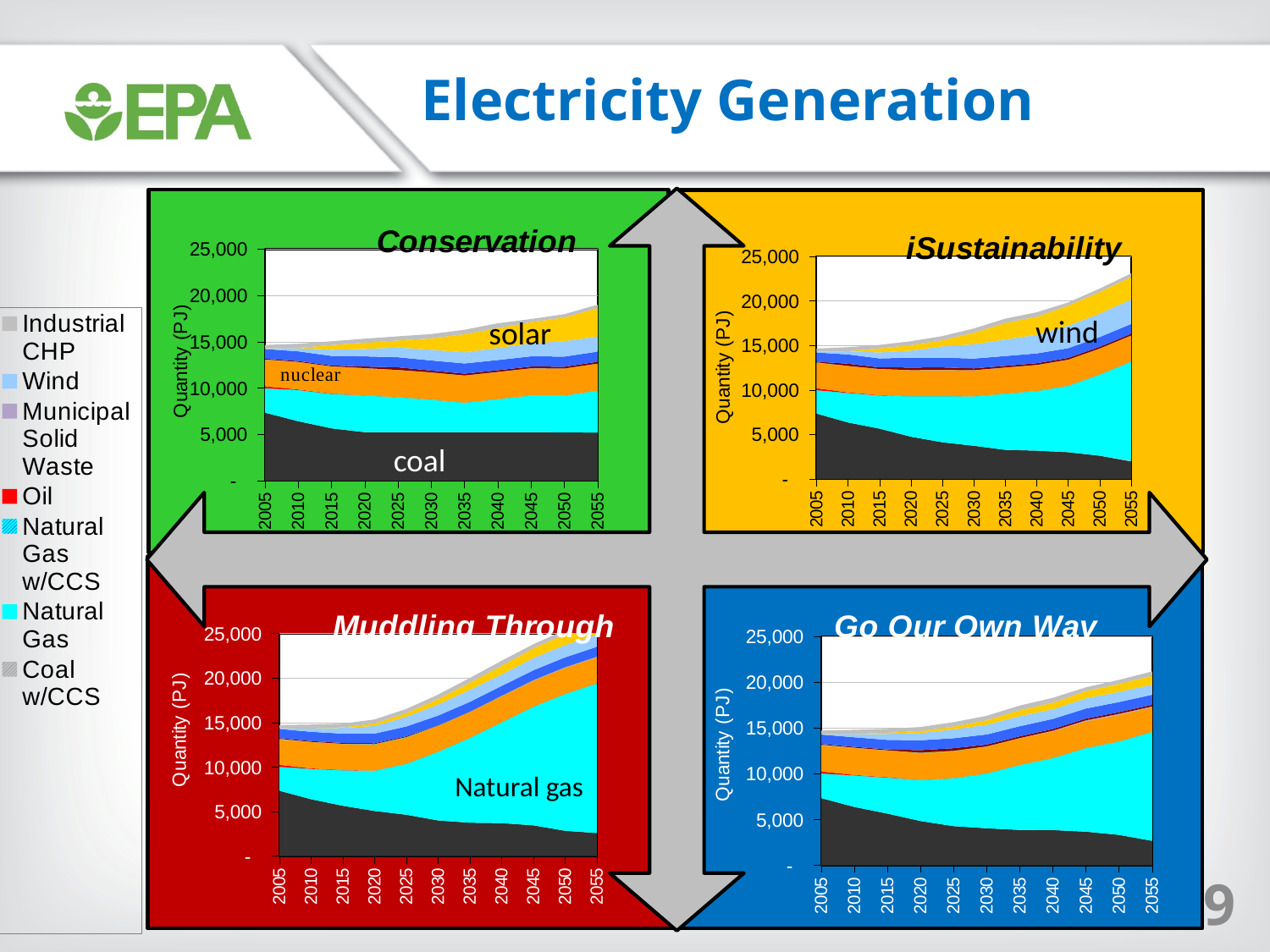
In the iSustainability chart, is the total electricity generation in 2055 greater or less than 20,000? greater In the Muddling Through chart, does total electricity generation rise or fall from 2005 to 2055? Rises Which scenario chart shows the larger total generation in 2055, Muddling Through or Conservation? Muddling Through In the Muddling Through chart, is the total electricity generation in 2055 greater or less than 20,000? greater In the Conservation chart, is the total electricity generation in 2055 greater or less than 20,000? less Which of the four scenario charts shows the lowest total generation in 2055? Conservation How many years are marked on the x axis of the Conservation chart? 11 What is the y-axis label on the scenario charts? Quantity (PJ) What kind of chart is used in each of the four scenario panels on the slide? Stacked area chart In the Conservation chart, does coal generation rise or fall from 2005 to 2055? Falls